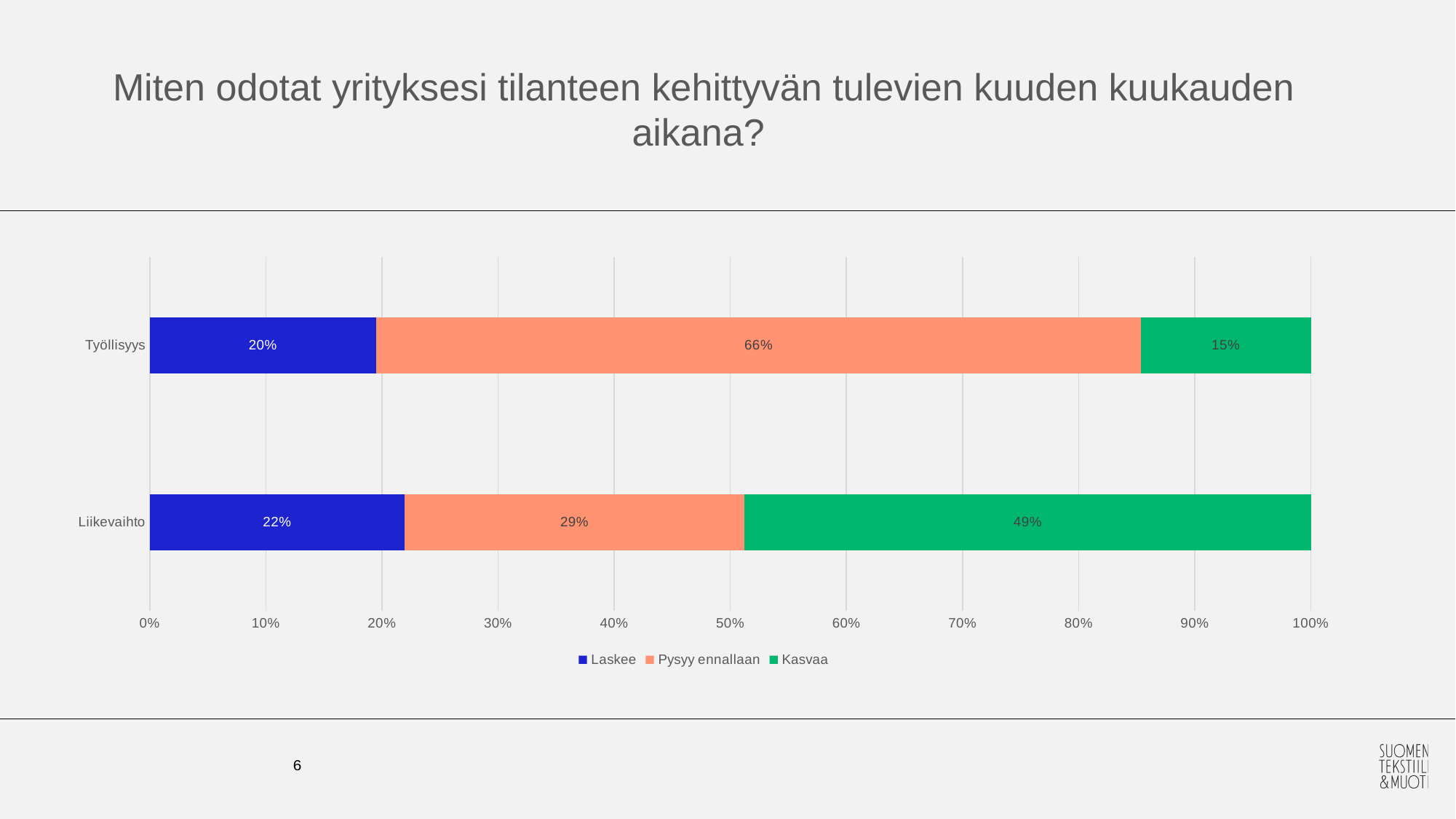
What kind of chart is shown on the slide? Stacked bar chart Which series has the largest share in the Työllisyys bar? Pysyy ennallaan What is the difference between the Kasvaa values for Liikevaihto and Työllisyys? 34 percentage points What is the value for Kasvaa in the Työllisyys bar? 15% What is the value for Kasvaa in the Liikevaihto bar? 49% What is the value for Pysyy ennallaan in the Työllisyys bar? 66% What is the value for Laskee in the Liikevaihto bar? 22% How many categories are shown on the chart? 2 Which series has the smallest share in the Liikevaihto bar? Laskee How many series does the legend list? 3 Which is larger: Pysyy ennallaan for Työllisyys or Pysyy ennallaan for Liikevaihto? Työllisyys Which colour represents the Kasvaa series? Green